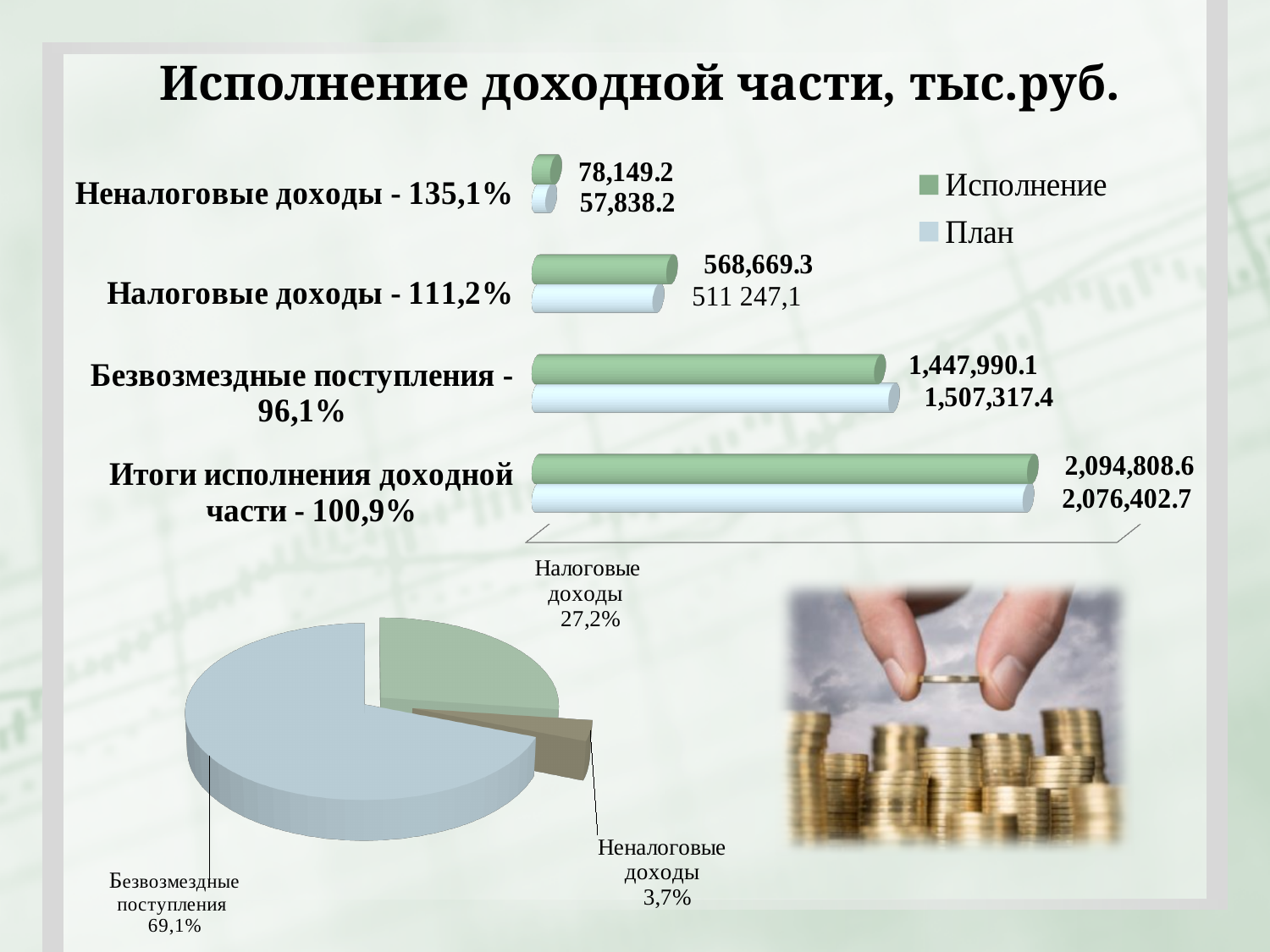
In the bar chart, what is the План value for Налоговые доходы? 511 247,1 What type of chart is the chart at the bottom left of the slide? Pie chart In the bar chart, what is the Исполнение value for Итоги исполнения доходной части? 2,094,808.6 In the bar chart, what is the План value for Безвозмездные поступления? 1,507,317.4 In the pie chart, what share does Безвозмездные поступления have? 69,1% In the bar chart, which category has the lowest Исполнение value? Неналоговые доходы How many series does the legend of the bar chart list? 2 In the bar chart, what is the Исполнение value for Неналоговые доходы? 78,149.2 How many categories are shown in the bar chart? 4 In the bar chart, what is the difference between the Исполнение and План values for Неналоговые доходы? 20,311.0 In the pie chart, which slice is the smallest? Неналоговые доходы In the bar chart, which is larger for Безвозмездные поступления: Исполнение or План? План